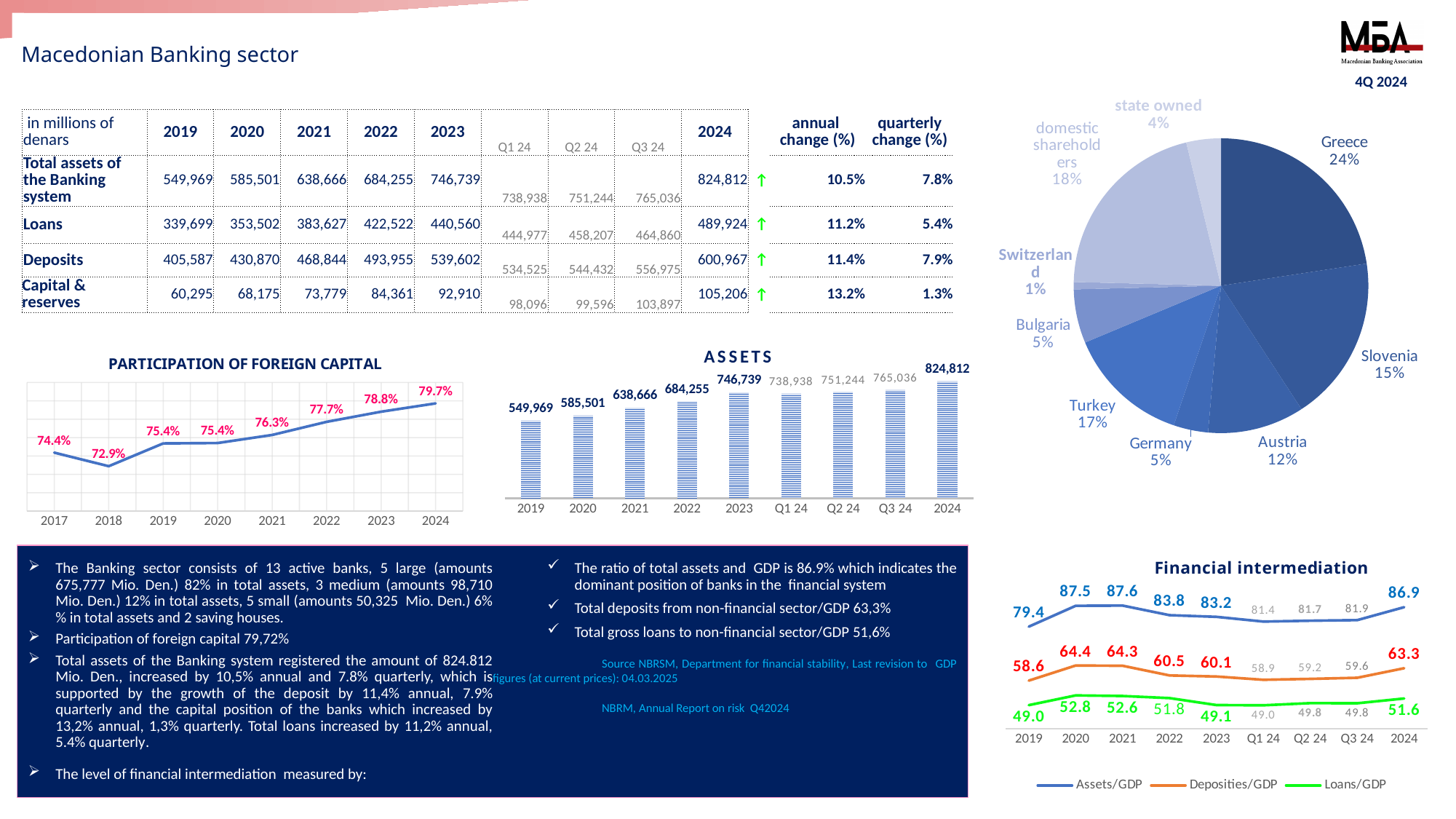
In the Financial intermediation chart, what is the Loans/GDP value for 2020? 52.8 In the Financial intermediation chart, how many series does the legend list? 3 In the pie chart at the top right, which slice is the smallest? Switzerland In the PARTICIPATION OF FOREIGN CAPITAL chart, what is the difference between the 2024 and 2017 values? 5.3 percentage points In the ASSETS chart, which period has the highest value? 2024 In the ASSETS chart, how many bars are plotted? 9 In the PARTICIPATION OF FOREIGN CAPITAL chart, what is the value for 2024? 79.7% In the pie chart at the top right, what share does Greece hold? 24% In the ASSETS chart, what is the value for Q3 24? 765,036 What kind of chart is the ASSETS chart? Bar chart In the PARTICIPATION OF FOREIGN CAPITAL chart, which year has the lowest value? 2018